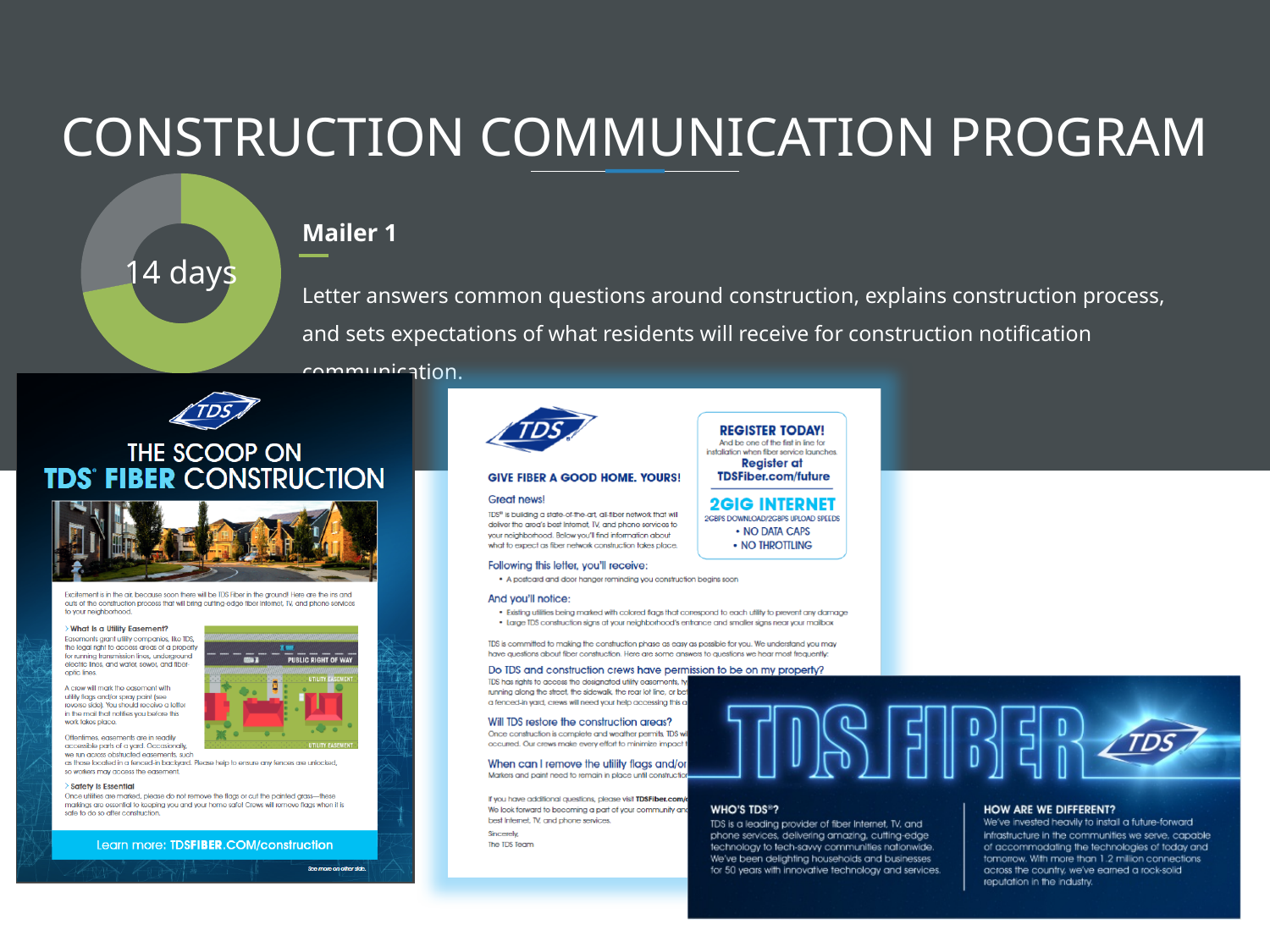
Which colour is used for the smaller segment of the doughnut chart? Gray Does the green segment of the doughnut chart cover more or less than half of the ring? More What kind of chart is shown on the left of the slide next to the 'Mailer 1' heading? Doughnut chart What text is printed in the center of the doughnut chart? 14 days How many segments does the doughnut chart on the slide have? 2 Which segment of the doughnut chart is larger, the green one or the gray one? Green